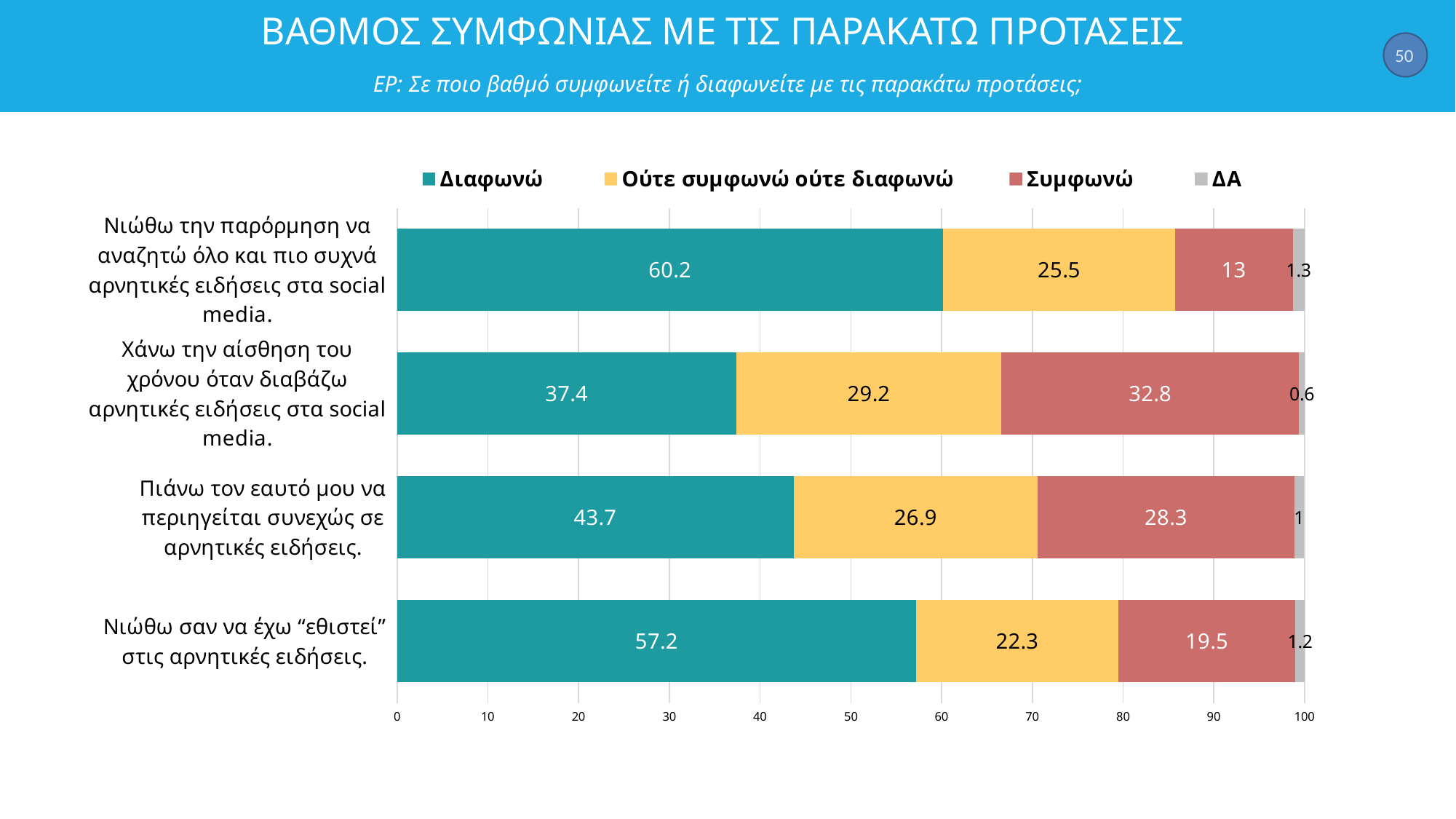
What is the ΔΑ value for the statement "Πιάνω τον εαυτό μου να περιηγείται συνεχώς σε αρνητικές ειδήσεις."? 1 Which statement has the highest Διαφωνώ value? Νιώθω την παρόρμηση να αναζητώ όλο και πιο συχνά αρνητικές ειδήσεις στα social media. What is the value of Διαφωνώ for the statement "Χάνω την αίσθηση του χρόνου όταν διαβάζω αρνητικές ειδήσεις στα social media."? 37.4 What is the total of the stacked bar for "Νιώθω την παρόρμηση να αναζητώ όλο και πιο συχνά αρνητικές ειδήσεις στα social media."? 100 Which statement has the lowest Συμφωνώ value? Νιώθω την παρόρμηση να αναζητώ όλο και πιο συχνά αρνητικές ειδήσεις στα social media. How many series does the legend list? 4 For the statement "Χάνω την αίσθηση του χρόνου όταν διαβάζω αρνητικές ειδήσεις στα social media.", what is the difference between the Διαφωνώ and Συμφωνώ values? 4.6 Which statement has the larger Ούτε συμφωνώ ούτε διαφωνώ value: "Χάνω την αίσθηση του χρόνου..." or "Πιάνω τον εαυτό μου να περιηγείται..."? Χάνω την αίσθηση του χρόνου όταν διαβάζω αρνητικές ειδήσεις στα social media. What kind of chart is shown on the slide? Stacked bar chart How many statements are shown in the chart? 4 Which colour represents Συμφωνώ in the legend? Red What is the value of Συμφωνώ for the statement "Νιώθω σαν να έχω “εθιστεί” στις αρνητικές ειδήσεις."? 19.5